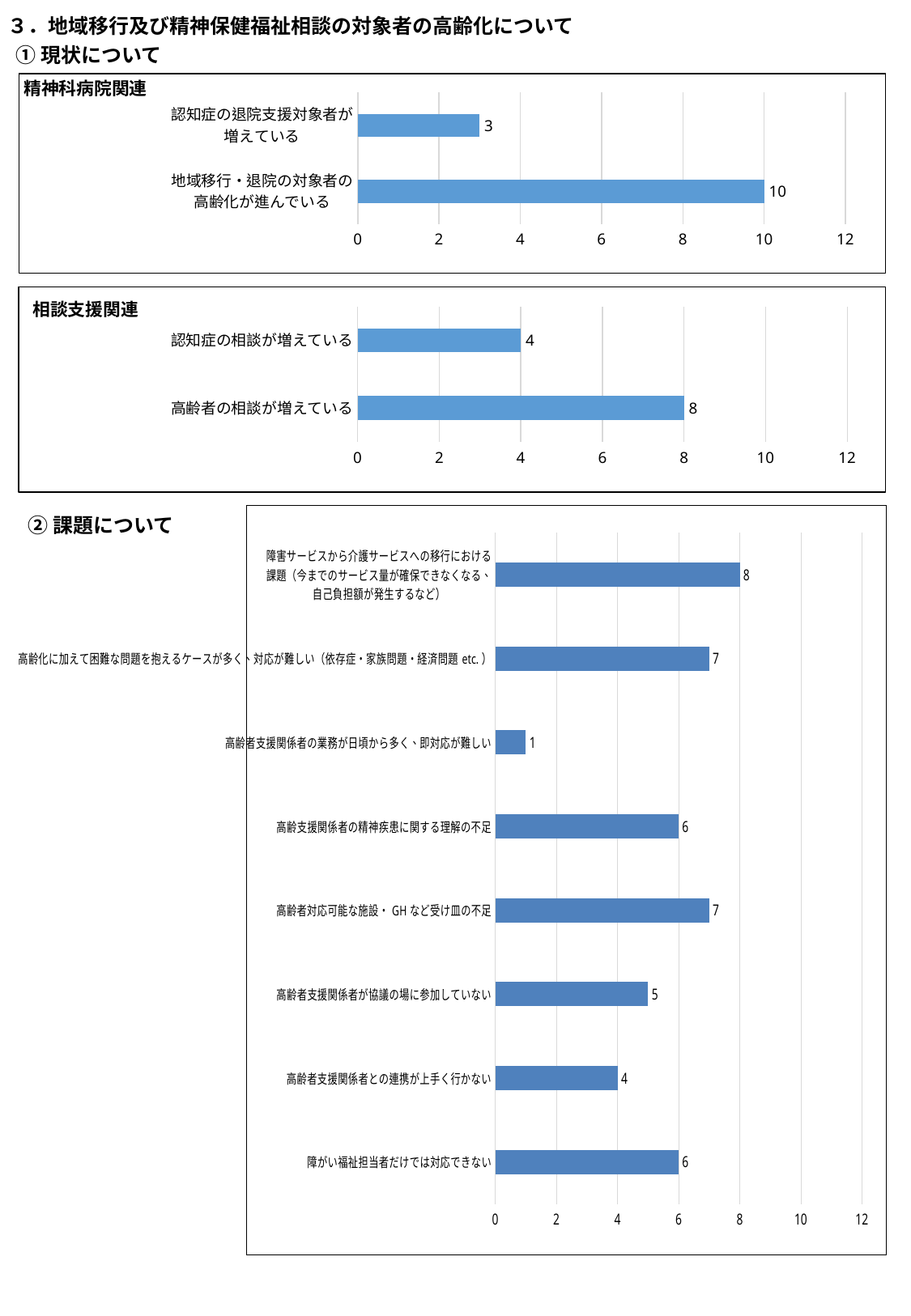
In the 相談支援関連 chart, what is the value for 高齢者の相談が増えている? 8 In the 相談支援関連 chart, what is the total of the two bars? 12 In the ② 課題について chart, which is larger: 高齢者支援関係者との連携が上手く行かない or 障がい福祉担当者だけでは対応できない? 障がい福祉担当者だけでは対応できない In the 精神科病院関連 chart, what is the value for 地域移行・退院の対象者の高齢化が進んでいる? 10 In the ② 課題について chart, how many categories are plotted? 8 In the 精神科病院関連 chart, what is the difference between the two bars? 7 In the ② 課題について chart, what is the value for 高齢者支援関係者が協議の場に参加していない? 5 What kind of chart is the ② 課題について chart? Bar chart In the 精神科病院関連 chart, what is the value for 認知症の退院支援対象者が増えている? 3 In the 相談支援関連 chart, which category has the lowest value? 認知症の相談が増えている In the ② 課題について chart, which category has the highest value? 障害サービスから介護サービスへの移行における課題（今までのサービス量が確保できなくなる、自己負担額が発生するなど） In the ② 課題について chart, which category has the lowest value? 高齢者支援関係者の業務が日頃から多く、即対応が難しい